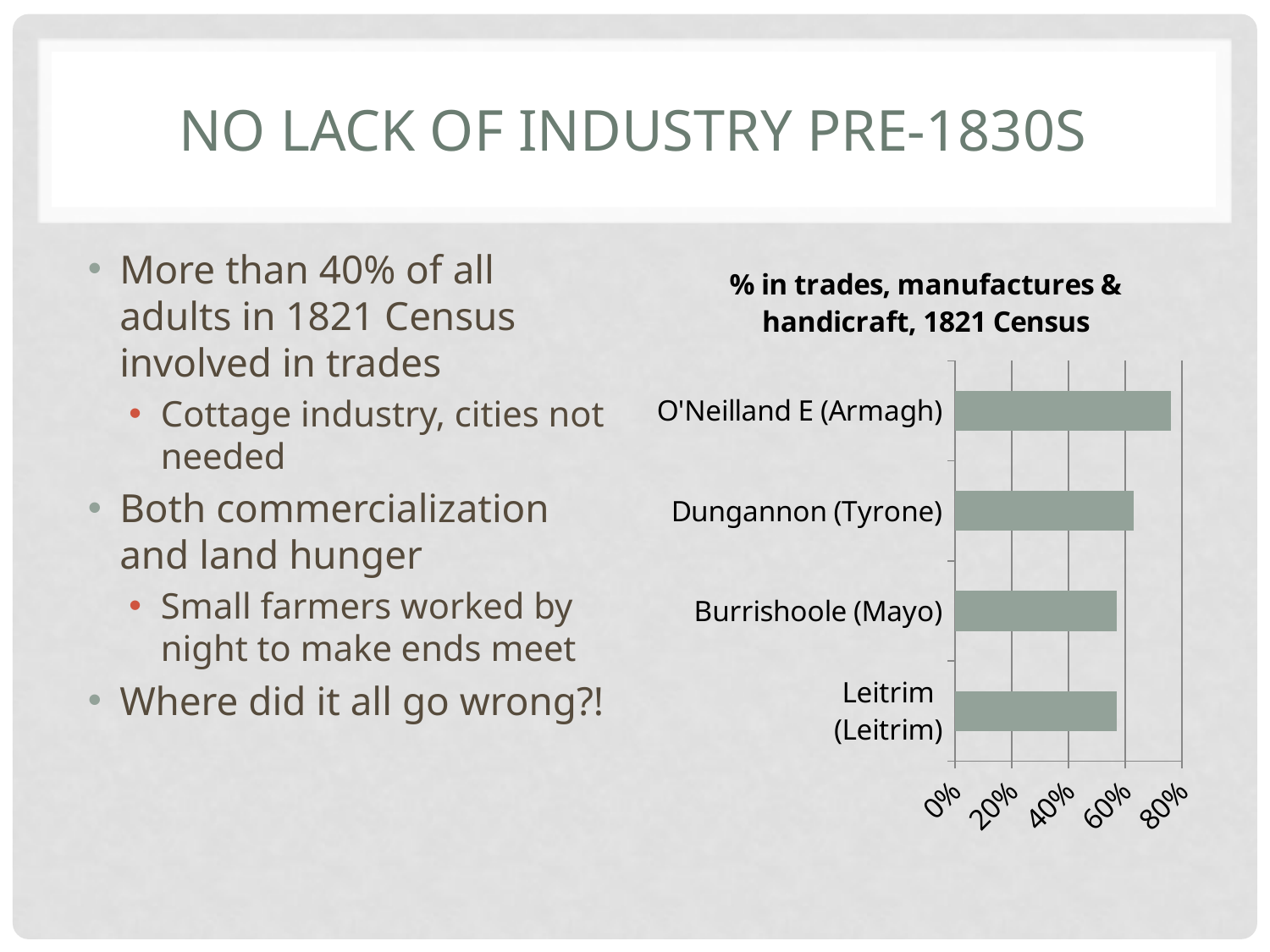
Is the value for Leitrim (Leitrim) greater or less than 40%? greater Which has the larger value, Dungannon (Tyrone) or Leitrim (Leitrim)? Dungannon (Tyrone) What is the highest tick label shown on the percentage axis? 80% Is the value for O'Neilland E (Armagh) greater or less than 60%? greater What is the title of the chart? % in trades, manufactures & handicraft, 1821 Census Which has the larger value, O'Neilland E (Armagh) or Dungannon (Tyrone)? O'Neilland E (Armagh) How many categories (places) are plotted in the chart? 4 Is the value for Dungannon (Tyrone) greater or less than 80%? less What type of chart is shown on the slide? bar chart Which place has the highest percentage in trades, manufactures & handicraft? O'Neilland E (Armagh)